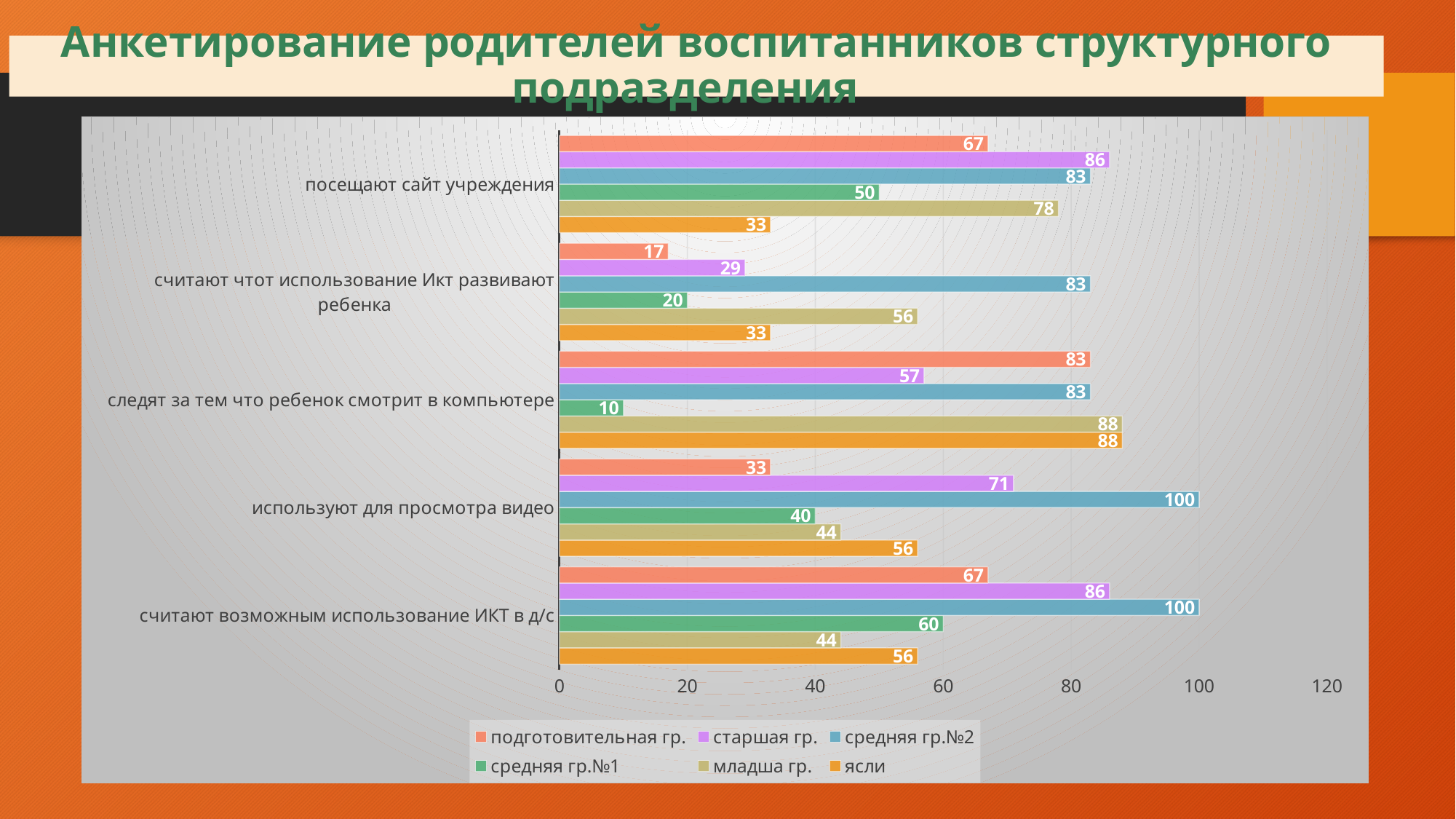
How many categories are shown on the vertical axis of the chart? 5 Which series has the lowest value in the category 'считают чтот использование Икт развивают ребенка'? подготовительная гр. What is the value for ясли in the category 'используют для просмотра видео'? 56 What is the value for средняя гр.№1 in the category 'следят за тем что ребенок смотрит в компьютере'? 10 Is the value for подготовительная гр. in the category 'следят за тем что ребенок смотрит в компьютере' greater or less than 60? greater What type of chart is shown on the slide? bar chart How many series does the legend list? 6 What is the difference between the values for средняя гр.№2 and старшая гр. in the category 'используют для просмотра видео'? 29 Which series has the highest value in the category 'считают возможным использование ИКТ в д/с'? средняя гр.№2 Which is larger in the category 'посещают сайт учреждения': the value for младша гр. or the value for средняя гр.№1? младша гр. What is the maximum value shown on the horizontal axis of the chart? 120 What is the value for старшая гр. in the category 'посещают сайт учреждения'? 86